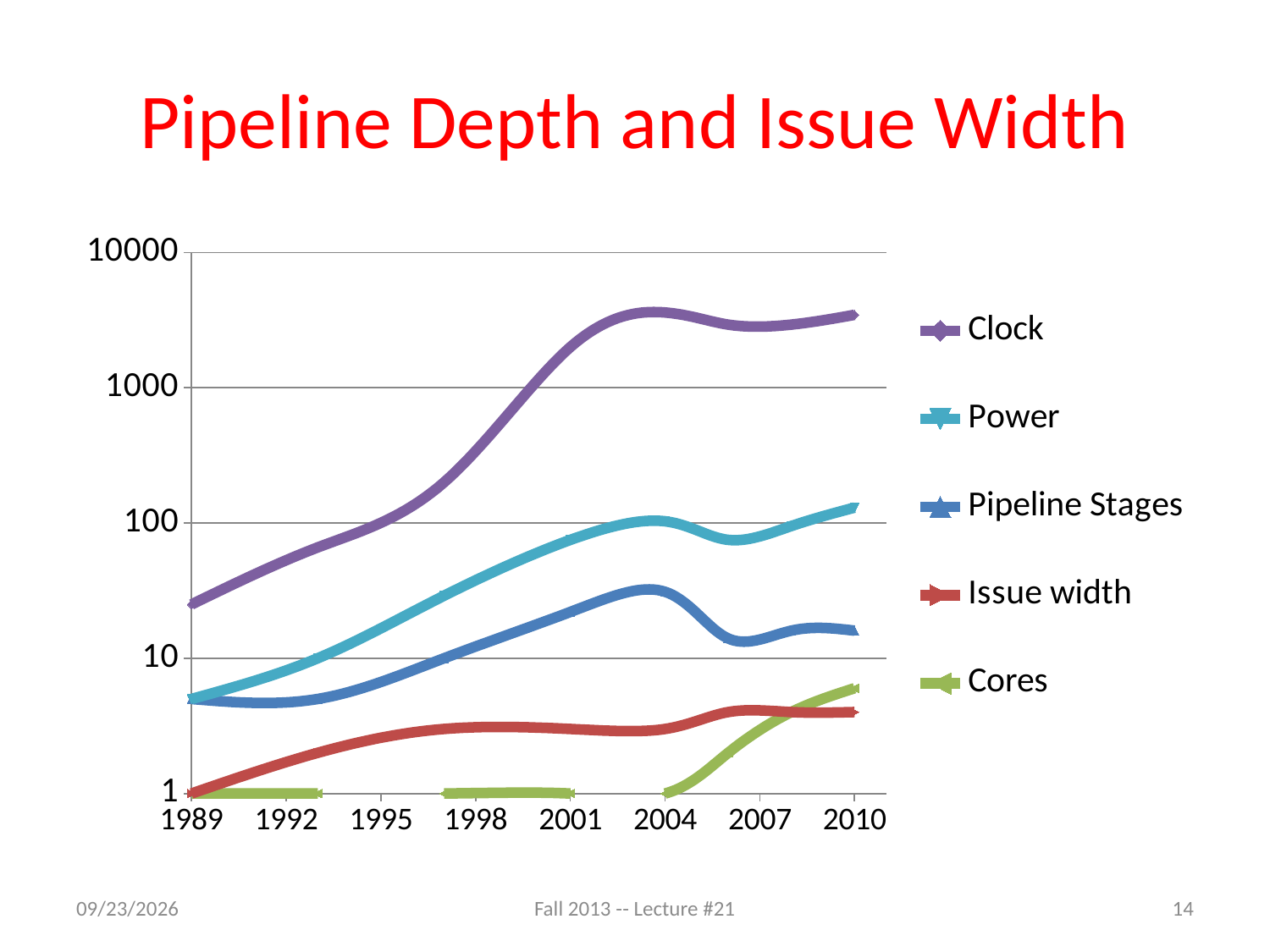
Is the value for Issue width in 2010 greater or less than 10? less How many year labels are shown on the x axis? 8 Is the value for Pipeline Stages in 2010 greater or less than 10? greater Does the Clock series rise or fall from 1989 to 2010? rise Is the value for Clock in 2010 greater or less than 1000? greater Which series has the highest value in 2010? Clock How many series does the legend list? 5 Which is larger in 2010, Clock or Power? Clock What kind of chart is shown on the slide? line chart What is the highest value labelled on the y axis? 10000 What is the value for Cores in 1989? 1